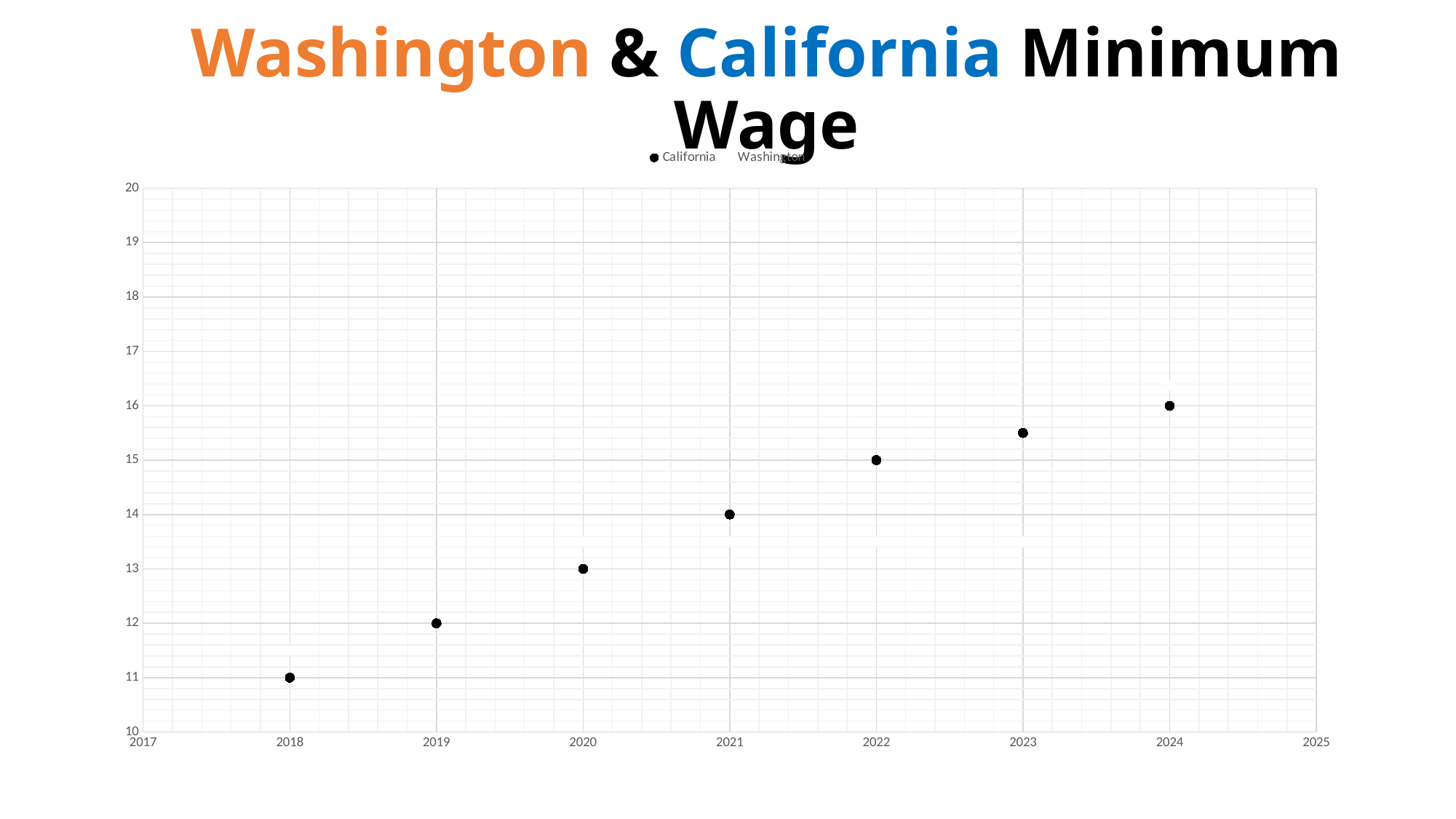
Do the California values rise or fall from 2018 to 2024? rise In which year is the California value highest? 2024 What is the California minimum wage value plotted for 2018? 11 How many series does the legend list? 2 What is the California minimum wage value plotted for 2022? 15 In which year is the California value lowest? 2018 What is the difference between the California values for 2024 and 2018? 5 Is the California value for 2023 greater or less than 15? greater What is the California minimum wage value plotted for 2024? 16 What kind of chart is shown on the slide? scatter chart How many California data points are plotted on the chart? 7 What is the California minimum wage value plotted for 2020? 13